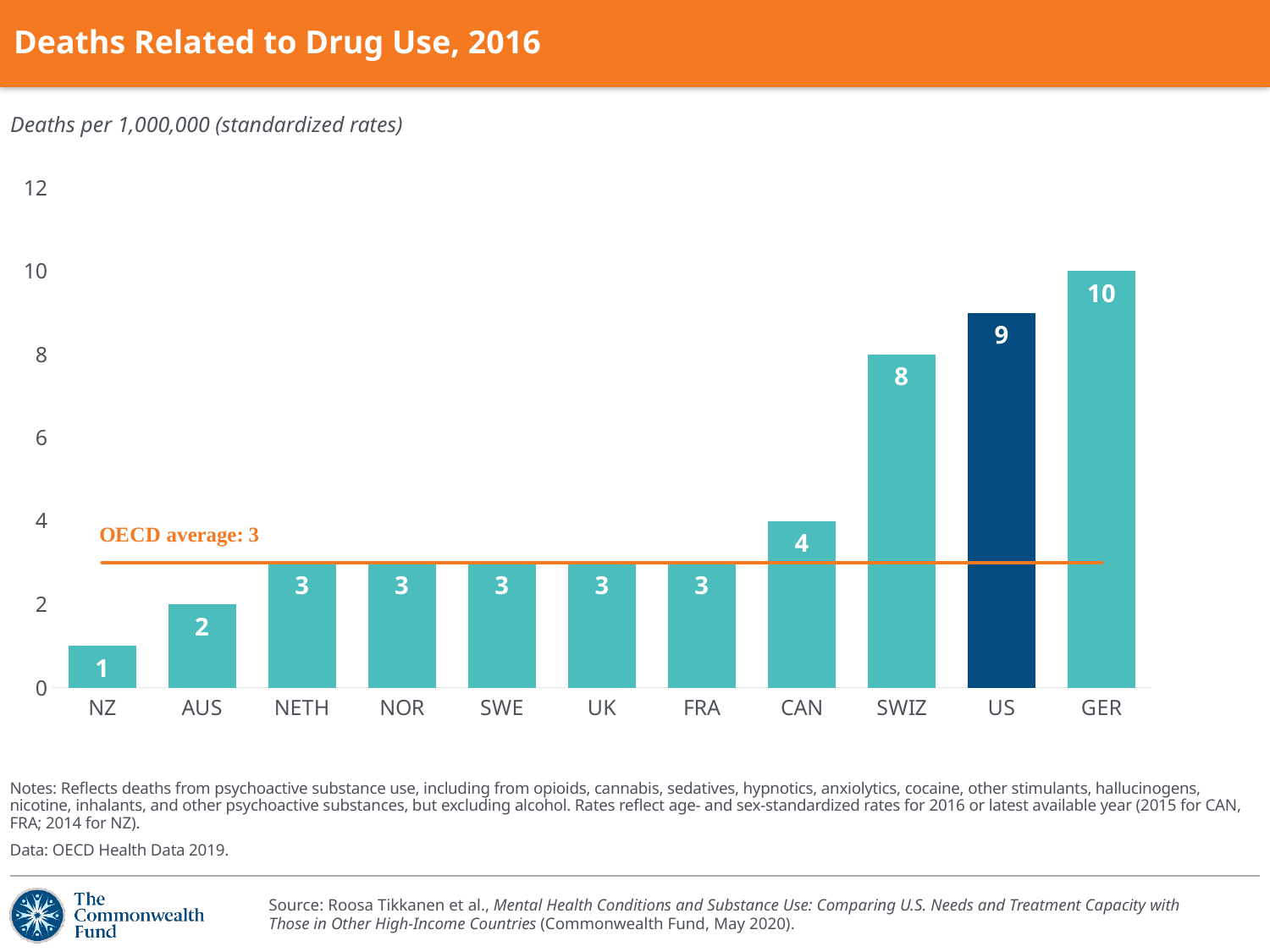
Is the value for SWIZ greater or less than 6? greater Which country has the highest value? GER What is the value for NZ? 1 Do the values generally rise or fall from left to right along the x axis? rise What is the difference between the values for GER and CAN? 6 What kind of chart is shown on the slide? bar chart Which is larger, the value for AUS or the value for CAN? CAN How many countries are shown in the chart? 11 What is the value for the US? 9 Which country has the lowest value? NZ What is the value for SWIZ? 8 What OECD average is marked by the horizontal line on the chart? 3